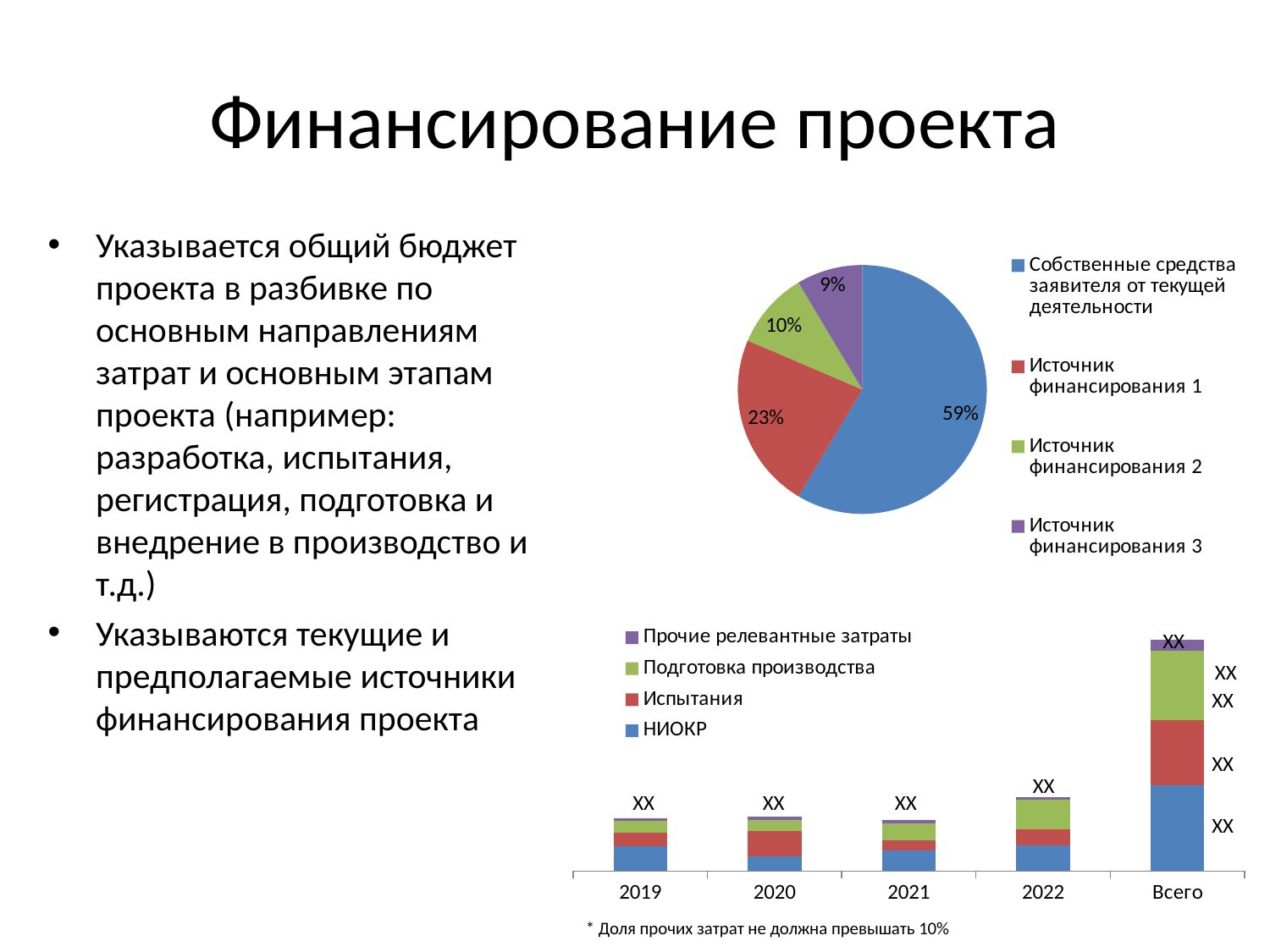
In the pie chart, what share is shown for 'Собственные средства заявителя от текущей деятельности'? 59% In the pie chart, what is the difference between the shares of 'Источник финансирования 1' and 'Источник финансирования 2'? 13% What kind of chart is the bottom chart on the slide? stacked bar chart In the pie chart, what share is shown for 'Источник финансирования 1'? 23% In the pie chart, which source has the largest share? Собственные средства заявителя от текущей деятельности In the pie chart, which source has the smallest share? Источник финансирования 3 In the pie chart, what share is shown for 'Источник финансирования 3'? 9% In the pie chart, how many slices are there? 4 In the bottom bar chart, how many series does the legend list? 4 In the bottom bar chart, how many categories are shown on the x axis? 5 In the bottom bar chart, which category has the tallest bar? Всего What kind of chart is the top-right chart on the slide? pie chart